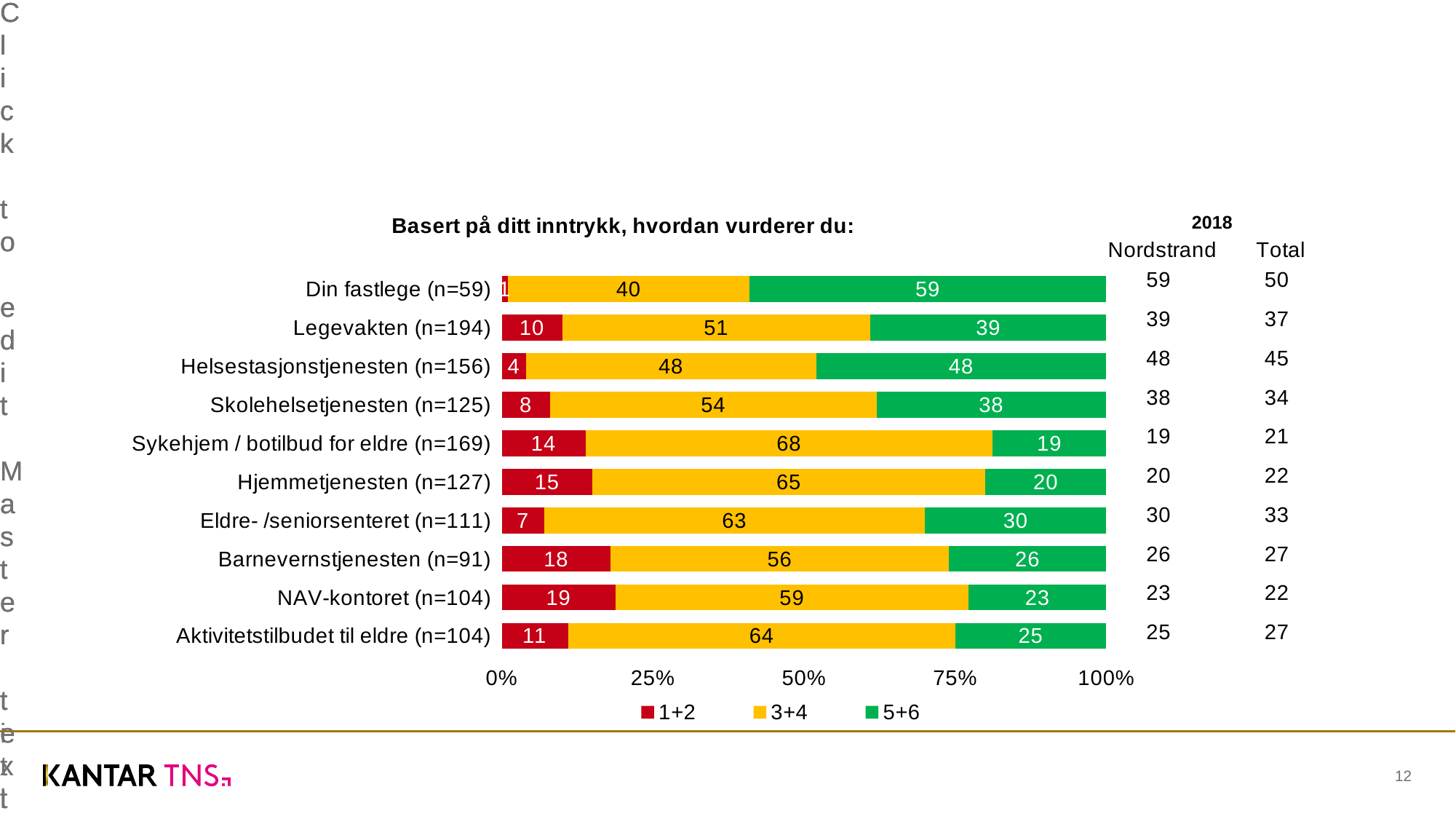
What is the value of the 5+6 series for Din fastlege (n=59)? 59 What is the title of the chart? Basert på ditt inntrykk, hvordan vurderer du: What is the value of the 1+2 series for NAV-kontoret (n=104)? 19 Which is larger: the 5+6 value for Eldre- /seniorsenteret (n=111) or for Barnevernstjenesten (n=91)? Eldre- /seniorsenteret (n=111) What is the difference between the 3+4 values for Hjemmetjenesten (n=127) and Legevakten (n=194)? 14 What kind of chart is shown on the slide? Stacked bar chart How many series does the legend list? 3 Which category has the highest value for the 5+6 series? Din fastlege (n=59) Which category has the lowest value for the 5+6 series? Sykehjem / botilbud for eldre (n=169) Which category has the highest value for the 1+2 series? NAV-kontoret (n=104) How many categories are shown in the chart? 10 What is the value of the 3+4 series for Sykehjem / botilbud for eldre (n=169)? 68